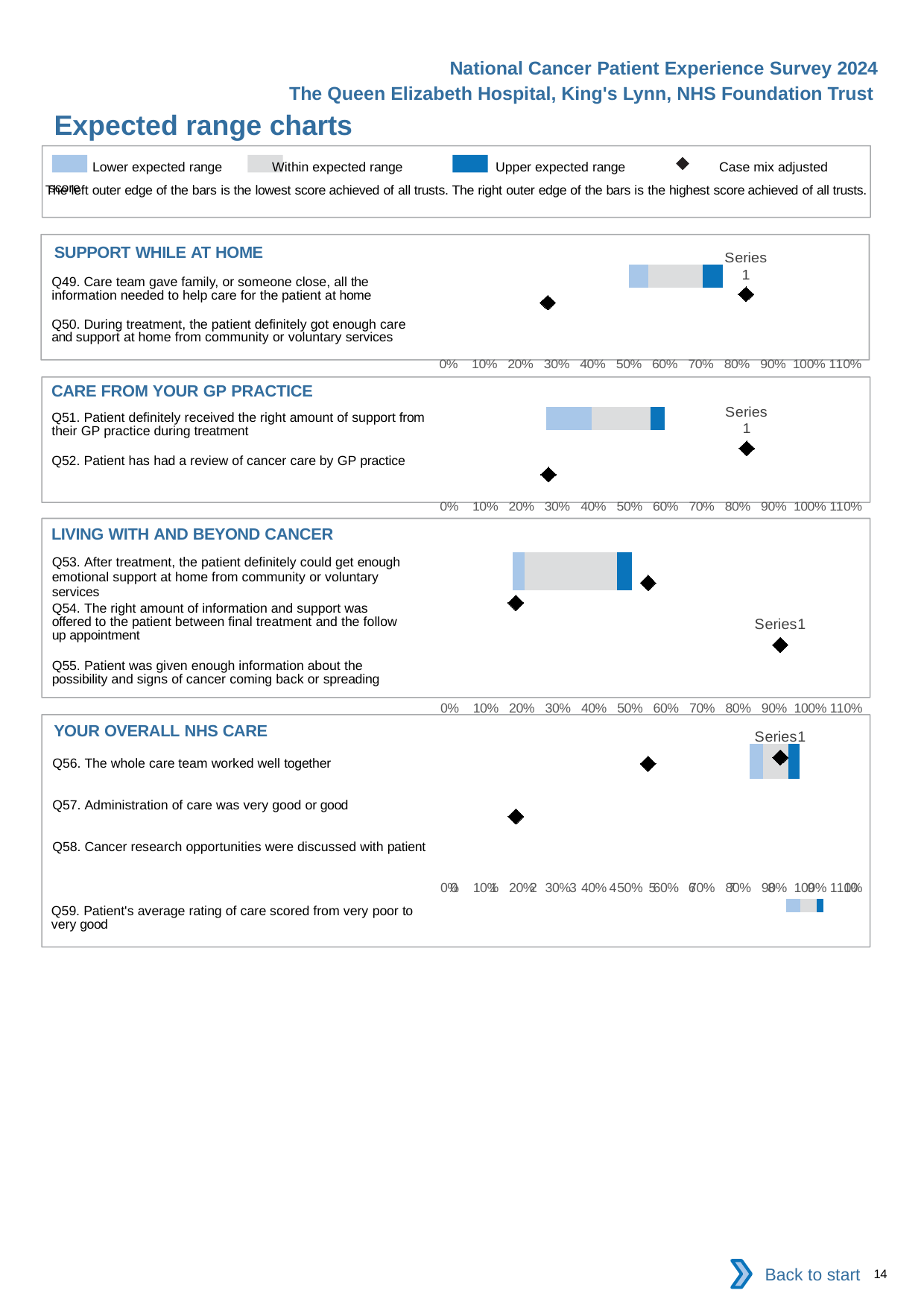
How many entries does the legend at the top of the slide list? 4 How many questions are listed in the SUPPORT WHILE AT HOME section? 2 What does the dark blue colour in the legend represent? Upper expected range How many questions are listed in the CARE FROM YOUR GP PRACTICE section? 2 In the SUPPORT WHILE AT HOME chart, is the leftmost case mix adjusted score marker greater or less than 40%? less How many questions are listed in the LIVING WITH AND BEYOND CANCER section? 3 What kind of chart is used in the SUPPORT WHILE AT HOME section? bar chart In the CARE FROM YOUR GP PRACTICE chart, is the rightmost case mix adjusted score marker greater or less than 70%? greater In the CARE FROM YOUR GP PRACTICE chart, is the leftmost case mix adjusted score marker greater or less than 40%? less What is the highest percentage tick shown on the x axis of the charts? 110%